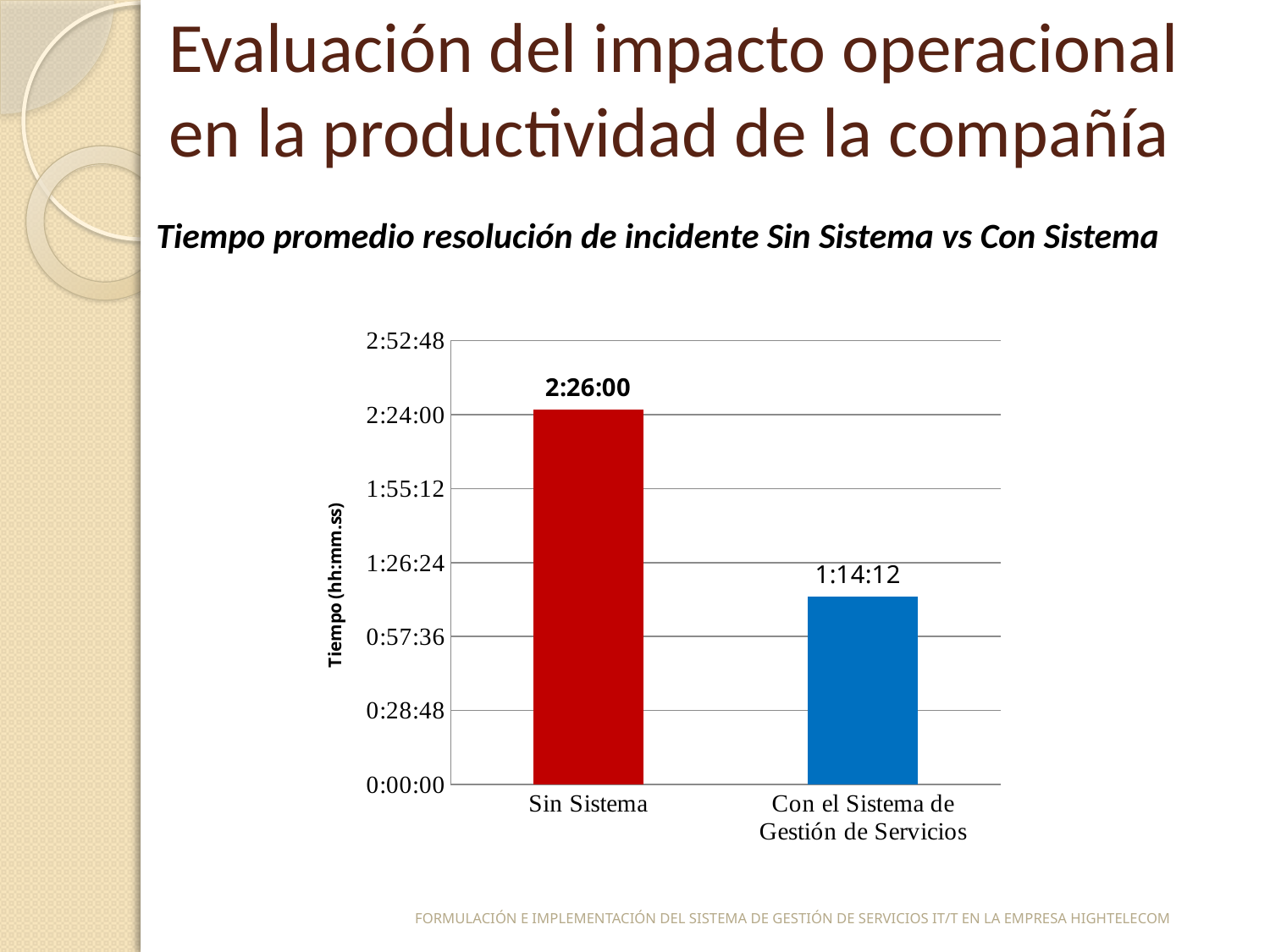
What is the difference between the resolution time for Sin Sistema and for Con el Sistema de Gestión de Servicios? 1:11:48 Is the value for Con el Sistema de Gestión de Servicios greater or less than 1:26:24? less What is the average incident resolution time for Sin Sistema? 2:26:00 What kind of chart is shown on the slide? Bar chart How many categories are shown on the chart? 2 Is the value for Sin Sistema greater or less than 1:55:12? greater What is the label of the vertical axis? Tiempo (hh:mm.ss) Which category has the highest resolution time? Sin Sistema Which is larger, the resolution time for Sin Sistema or for Con el Sistema de Gestión de Servicios? Sin Sistema Which category has the lowest resolution time? Con el Sistema de Gestión de Servicios What is the average incident resolution time for Con el Sistema de Gestión de Servicios? 1:14:12 What colour is the bar for Sin Sistema? Red